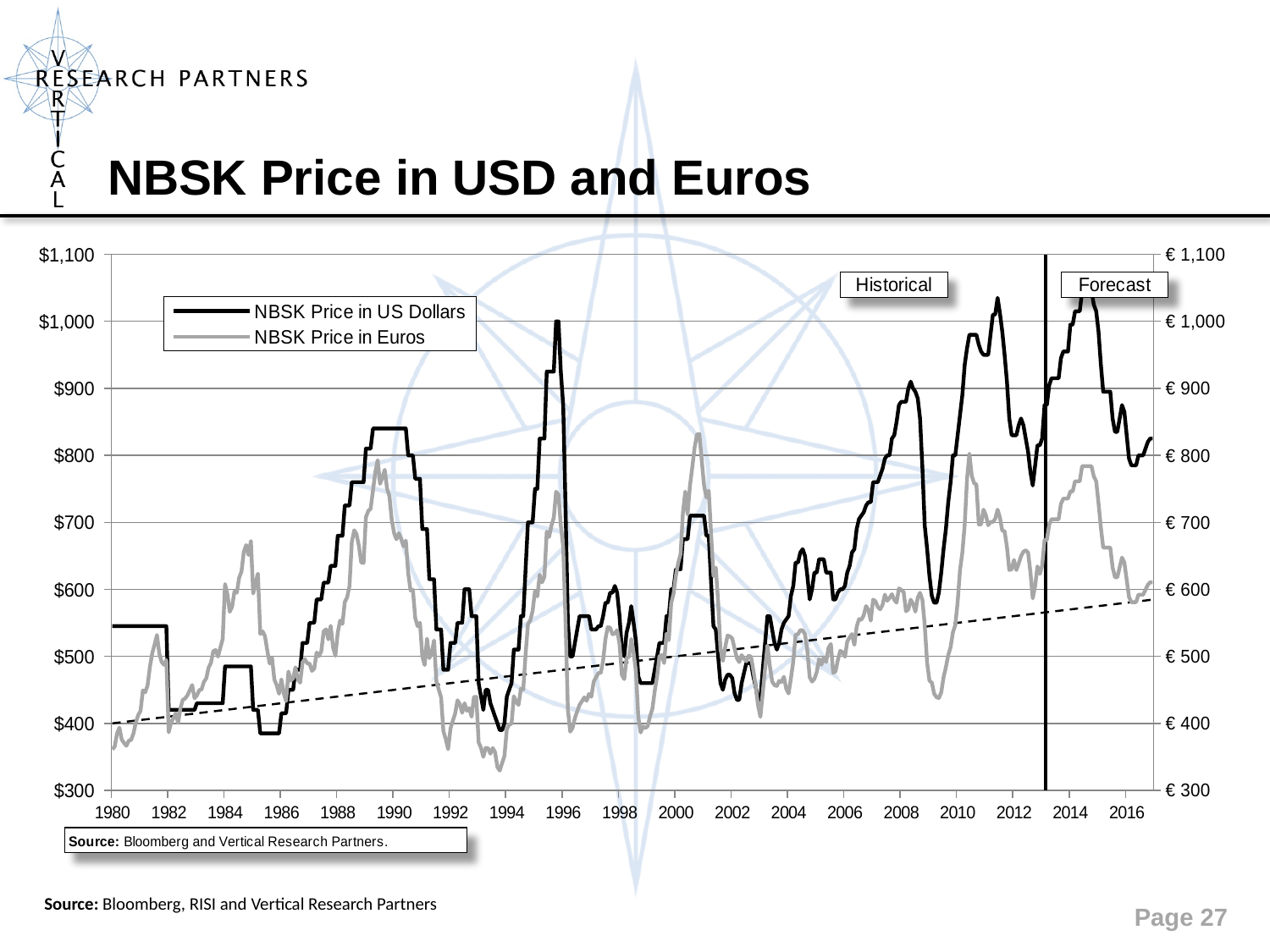
Around 2014, which is numerically higher: the NBSK Price in US Dollars or the NBSK Price in Euros? NBSK Price in US Dollars What is the title of the chart? NBSK Price in USD and Euros How many series does the legend list? 2 Is the peak NBSK Price in Euros around 2014 greater or less than €800? less Is the NBSK Price in Euros at the start of 1980 greater or less than €400? less What kind of chart is shown on the slide? line chart Is the lowest NBSK Price in Euros around 2009 greater or less than €500? less Does the dashed trend line rise or fall from 1980 to 2016? rise Which series is drawn in black according to the legend? NBSK Price in US Dollars